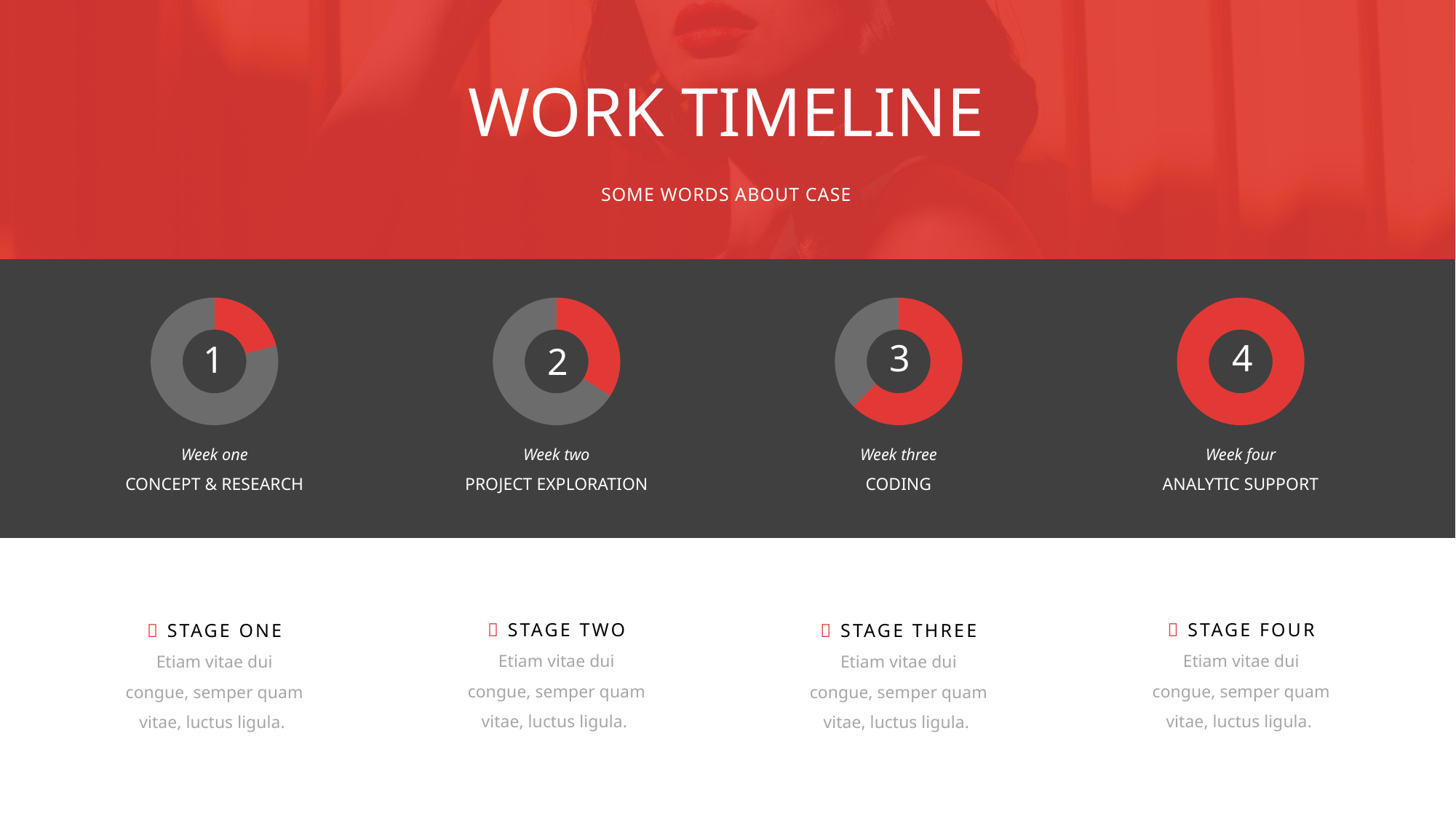
How many donut charts are shown on the slide? 4 What number is shown in the centre of the donut chart labelled Week three? 3 Which donut chart has a larger red portion, Week two or Week three? Week three What stage name is shown under the donut chart for Week two? PROJECT EXPLORATION Which week's donut chart has the largest red (filled) portion? Week four Which week's donut chart has the smallest red (filled) portion? Week one Does the red (filled) portion of the donut charts increase or decrease from Week one to Week four? Increase What is the title of the slide containing the donut charts? WORK TIMELINE What kind of chart is used for each of the four weeks on the slide? Donut chart Which donut chart is completely filled in red? Week four Which donut chart has a larger red portion, Week one or Week four? Week four